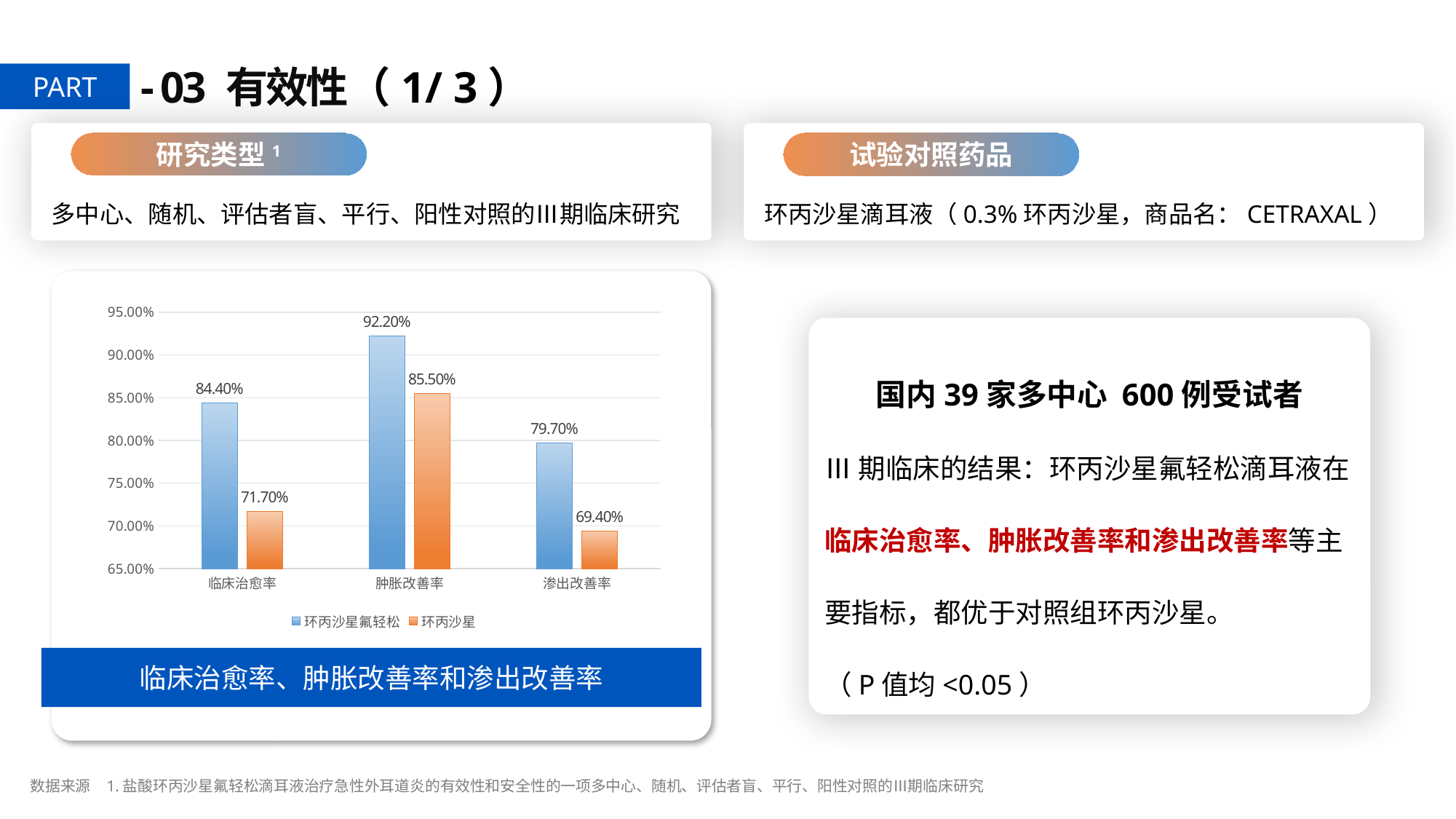
What type of chart is shown on the slide? bar chart Which colour represents the 环丙沙星 series in the chart? orange In which category does 环丙沙星氟轻松 have its highest value? 肿胀改善率 What is the value for 环丙沙星氟轻松 in the 临床治愈率 category? 84.40% What is the value for 环丙沙星 in the 渗出改善率 category? 69.40% How many series does the chart legend list? 2 What is the value for 环丙沙星 in the 肿胀改善率 category? 85.50% What is the difference between 环丙沙星氟轻松 and 环丙沙星 in the 临床治愈率 category? 12.70% Which series has the larger value in the 肿胀改善率 category, 环丙沙星氟轻松 or 环丙沙星? 环丙沙星氟轻松 How many categories are shown on the x axis of the chart? 3 What is the difference between 环丙沙星氟轻松 and 环丙沙星 in the 渗出改善率 category? 10.30% In which category does 环丙沙星 have its lowest value? 渗出改善率